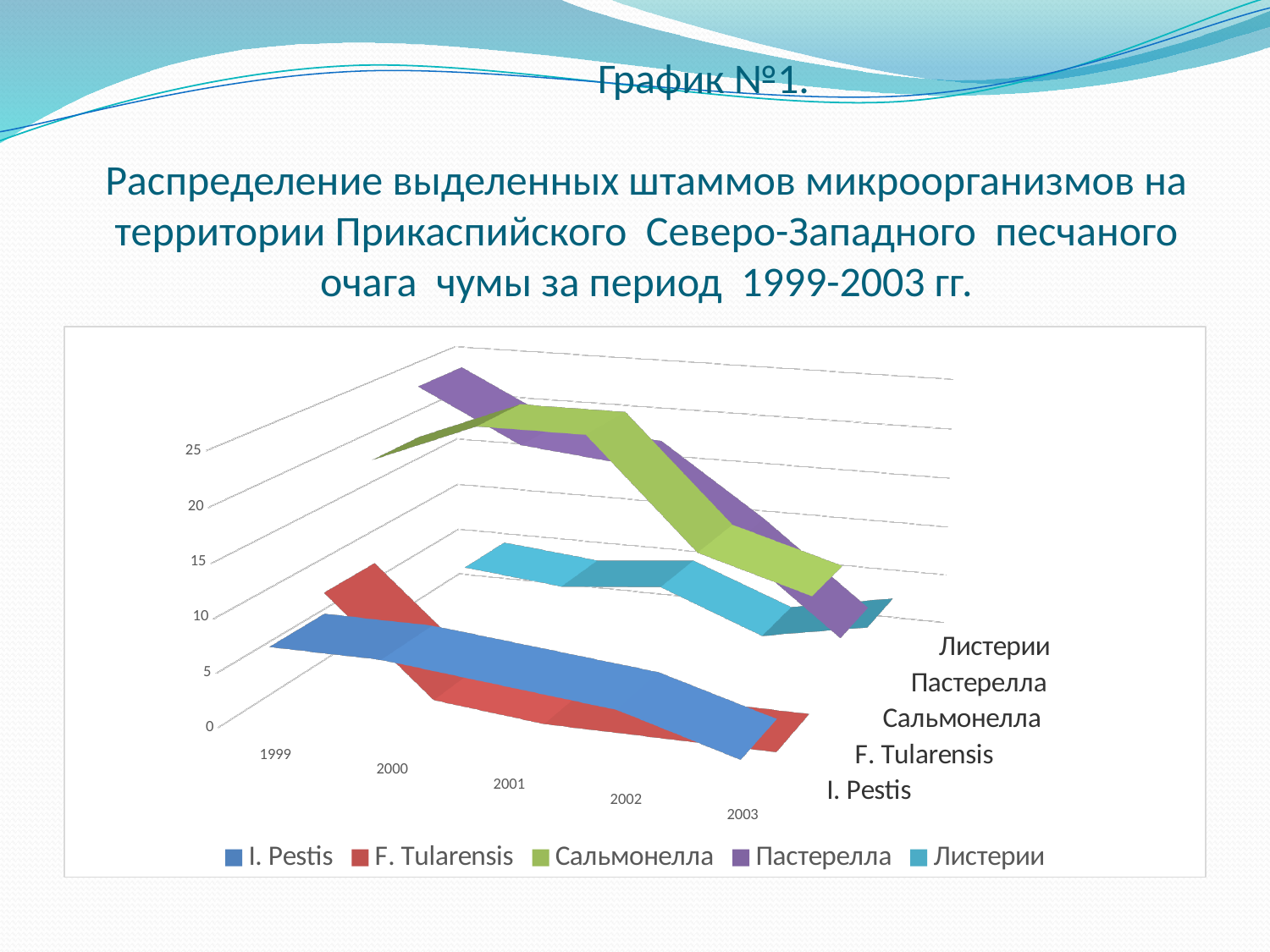
What kind of chart is shown on the slide? 3D line chart Does the value for Пастерелла rise or fall from 2001 to 2003? fall Does the value for F. Tularensis rise or fall from 1999 to 2003? fall Does the value for I. Pestis rise or fall from 1999 to 2003? fall How many years are shown along the x axis? 5 Which series is drawn in green? Сальмонелла Which series is listed first in the legend? I. Pestis How many series does the legend list? 5